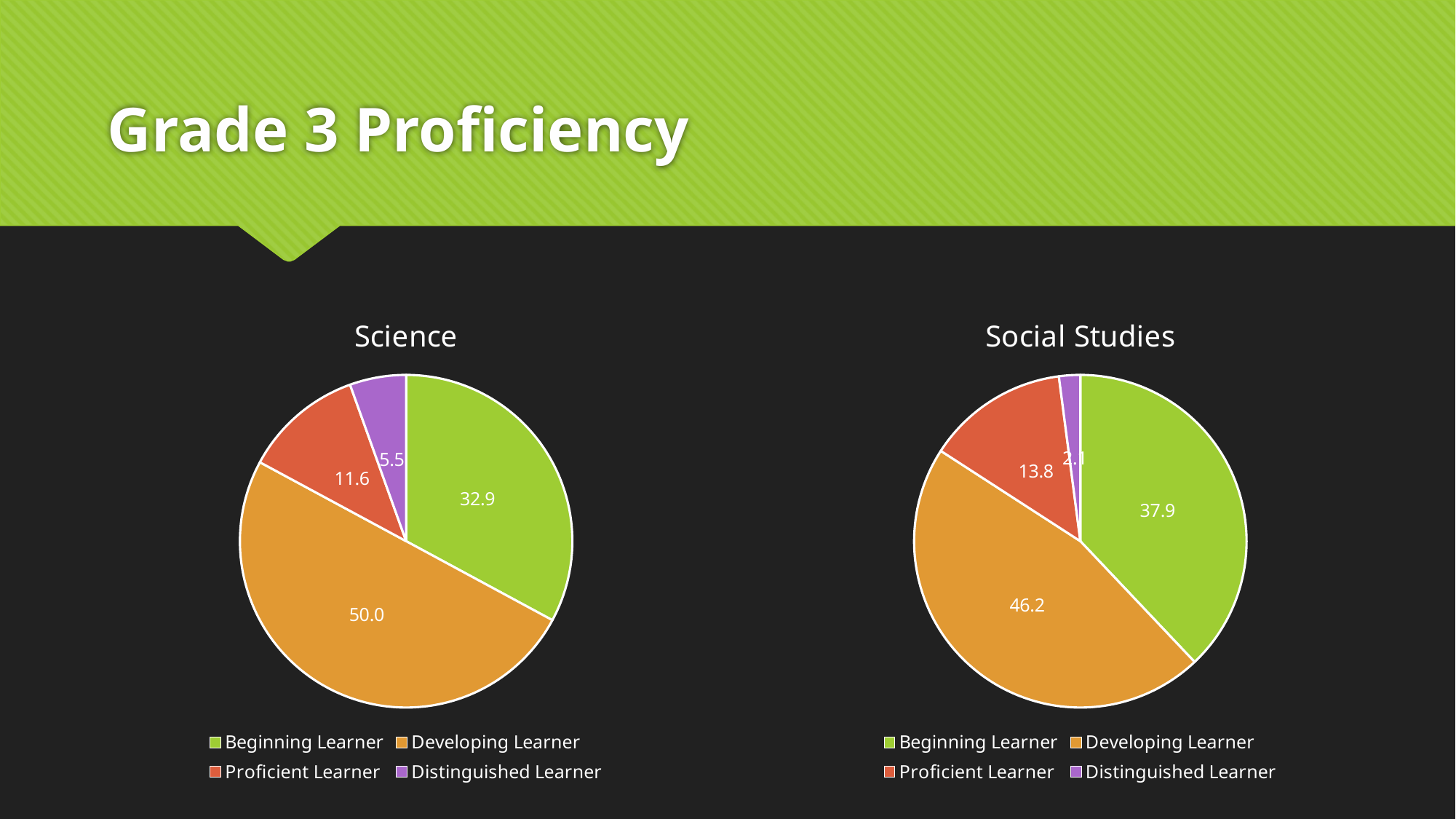
How many categories does the Science chart show? 4 Which is larger: the Proficient Learner value in the Science chart or in the Social Studies chart? Social Studies In the Social Studies chart, what is the value for Beginning Learner? 37.9 In the Social Studies chart, what is the difference between the Developing Learner and Beginning Learner values? 8.3 In the Social Studies chart, what is the value for Proficient Learner? 13.8 In the Science chart, what is the value for Distinguished Learner? 5.5 In the Science chart, which category has the largest slice? Developing Learner In the Science chart, which colour represents Developing Learner? Orange What kind of chart is the Social Studies chart? Pie chart In the Science chart, what is the value for Developing Learner? 50.0 In the Science chart, what is the difference between the Beginning Learner and Proficient Learner values? 21.3 In the Social Studies chart, which category has the smallest slice? Distinguished Learner